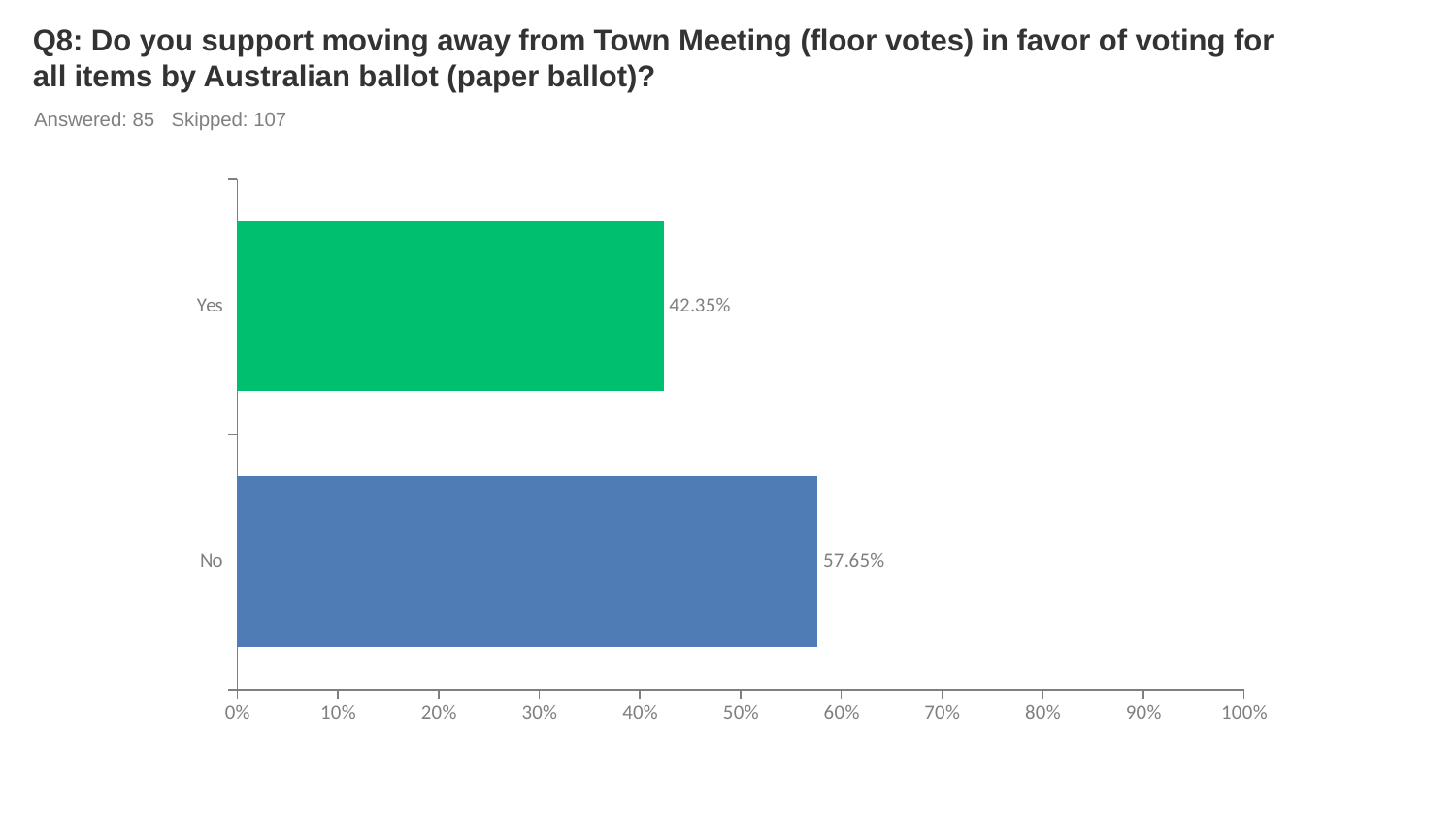
What type of chart is shown on the slide? bar chart Is the value for Yes greater or less than 50%? less How many response categories are shown in the chart? 2 How many people skipped this question? 107 Which response received the highest percentage? No How many people answered this question? 85 What percentage of respondents answered No? 57.65% Which is larger, the percentage for Yes or the percentage for No? No What is the difference in percentage points between the No and Yes responses? 15.30 Which response received the lowest percentage? Yes What percentage of respondents answered Yes? 42.35% Is the value for No greater or less than 50%? greater